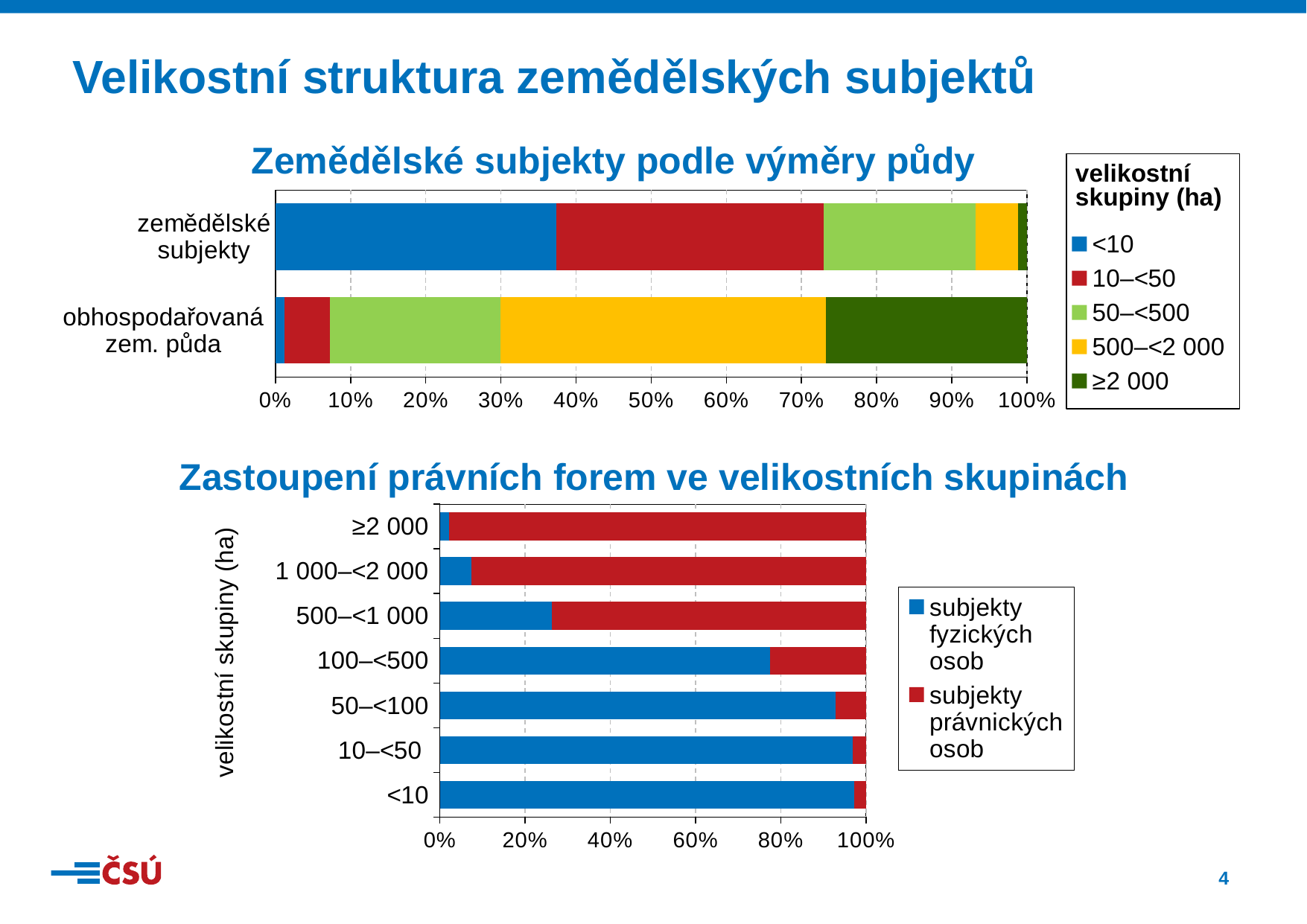
How many categories (bars) are shown in the chart "Zemědělské subjekty podle výměry půdy"? 2 How many size groups (categories) are shown in the chart "Zastoupení právních forem ve velikostních skupinách"? 7 In the chart "Zastoupení právních forem ve velikostních skupinách", which size group has the smallest share of subjekty fyzických osob? ≥2 000 What kind of chart is the chart titled "Zemědělské subjekty podle výměry půdy"? stacked bar chart In the chart "Zastoupení právních forem ve velikostních skupinách", which is larger in the ≥2 000 group: subjekty fyzických osob or subjekty právnických osob? subjekty právnických osob In the chart "Zemědělské subjekty podle výměry půdy", is the <10 ha share of obhospodařovaná zem. půda greater or less than 10%? less In the chart "Zemědělské subjekty podle výměry půdy", is the <10 ha share of zemědělské subjekty greater or less than 30%? greater In the chart "Zemědělské subjekty podle výměry půdy", which size group has the largest segment in the obhospodařovaná zem. půda bar? 500–<2 000 How many series does the legend of the chart "Zemědělské subjekty podle výměry půdy" list? 5 How many series does the legend of the chart "Zastoupení právních forem ve velikostních skupinách" list? 2 In the chart "Zemědělské subjekty podle výměry půdy", which size group has the smallest segment in the obhospodařovaná zem. půda bar? <10 In the chart "Zastoupení právních forem ve velikostních skupinách", is the share of subjekty fyzických osob in the 100–<500 group greater or less than 60%? greater